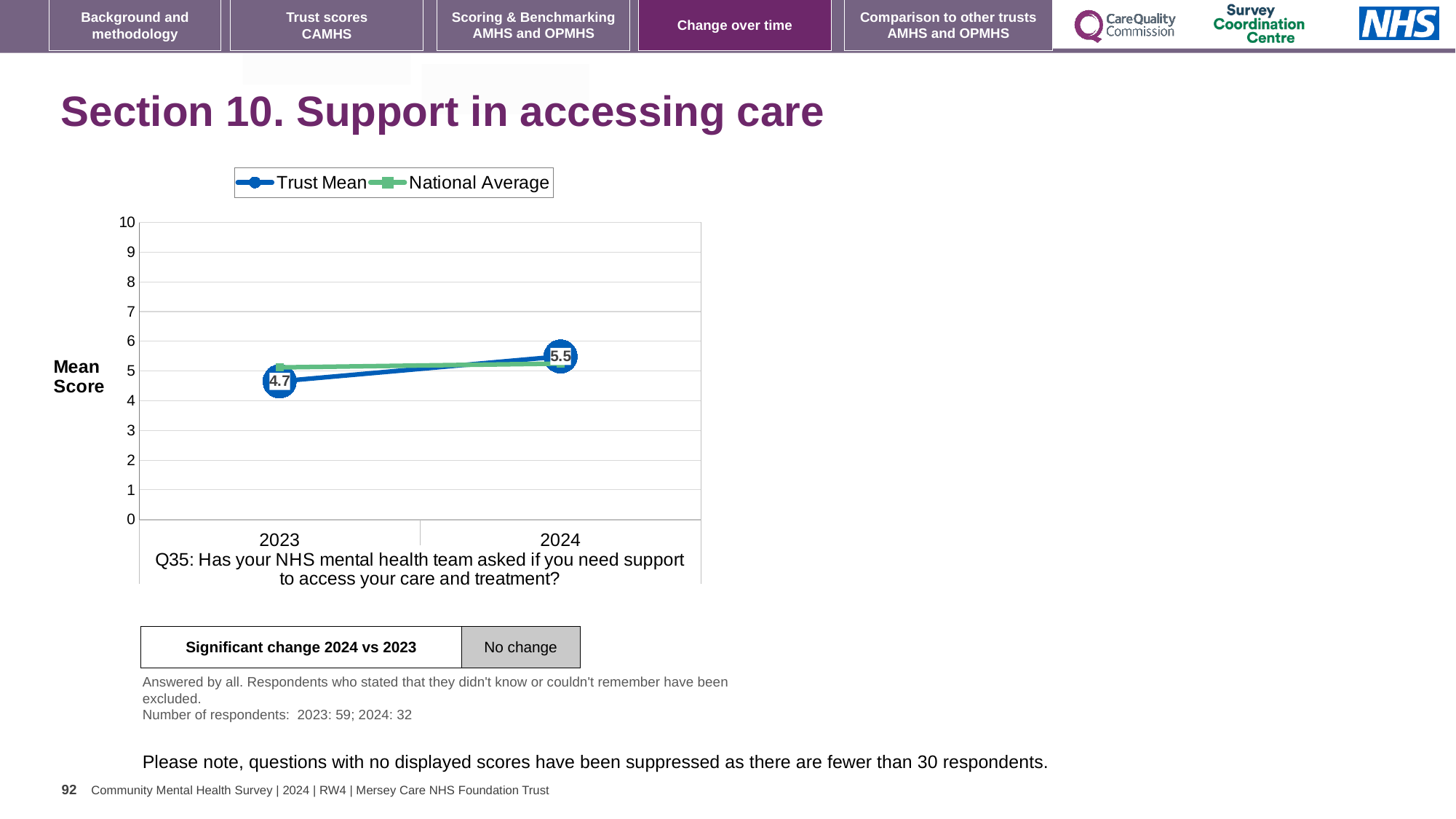
Is the National Average value for 2024 greater or less than 4? greater Does the Trust Mean rise or fall from 2023 to 2024? rise Is the National Average value for 2023 greater or less than 6? less By how much did the Trust Mean change from 2023 to 2024? 0.8 How many years are shown on the x axis? 2 Which year has the lower Trust Mean score? 2023 Which year has the higher Trust Mean score? 2024 What kind of chart is shown on the slide? line chart How many series does the legend list? 2 In 2023, which is higher: the Trust Mean or the National Average? National Average What is the Trust Mean score for 2023? 4.7 What is the Trust Mean score for 2024? 5.5